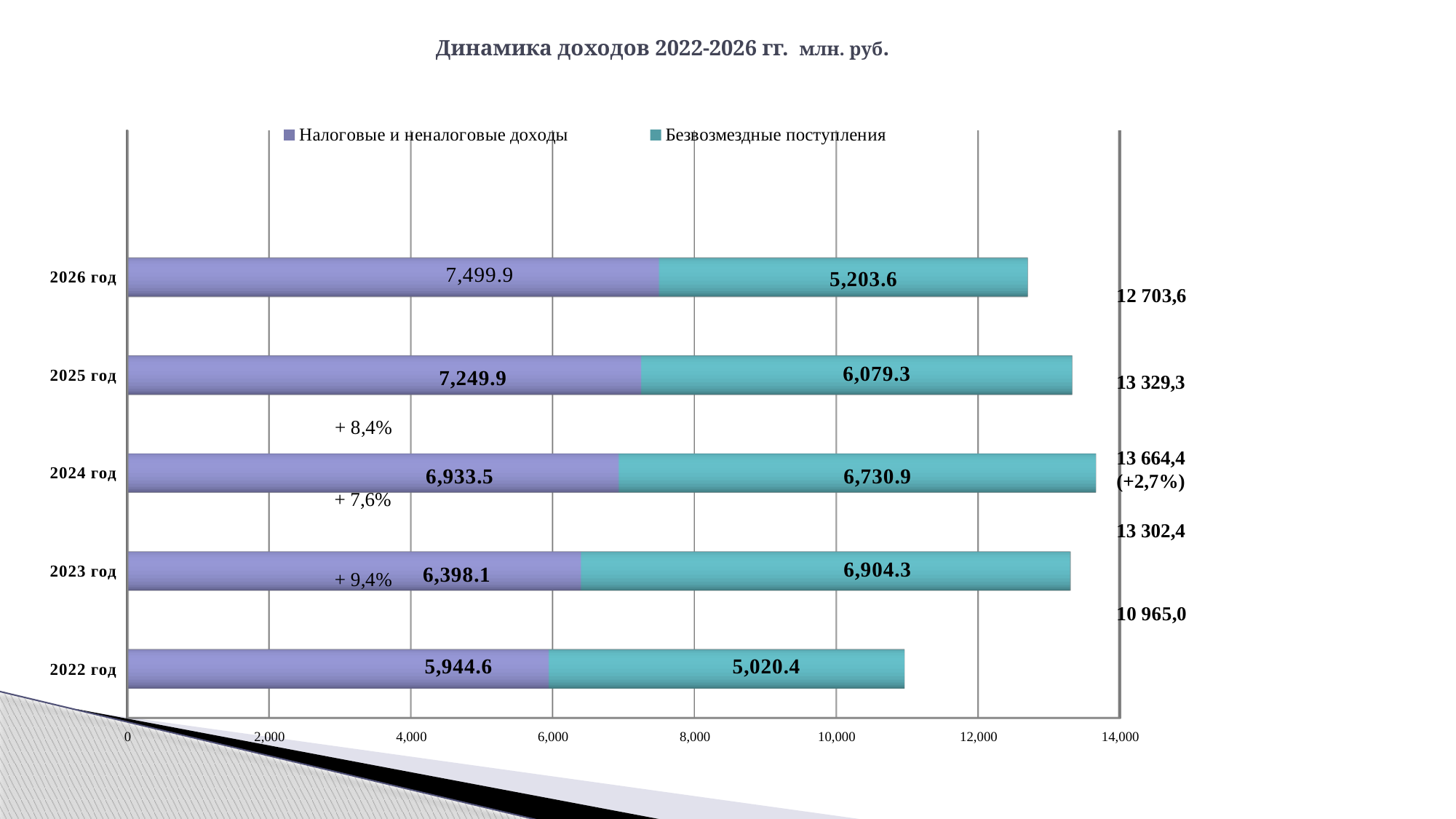
Which year has the lowest value of Безвозмездные поступления? 2022 год What is the value of Безвозмездные поступления for 2023 год? 6,904.3 How many years are plotted on the chart? 5 What is the value of Налоговые и неналоговые доходы for 2026 год? 7,499.9 What is the difference between Налоговые и неналоговые доходы in 2025 год and 2024 год? 316.4 Do the values of Налоговые и неналоговые доходы rise or fall from 2022 год to 2026 год? rise In 2024 год, which is larger: Налоговые и неналоговые доходы or Безвозмездные поступления? Налоговые и неналоговые доходы What is the total of the stacked bar for 2022 год? 10 965,0 How many series does the legend list? 2 Which year has the highest value of Налоговые и неналоговые доходы? 2026 год What kind of chart is shown on the slide? bar chart What is the total of the stacked bar for 2024 год? 13 664,4